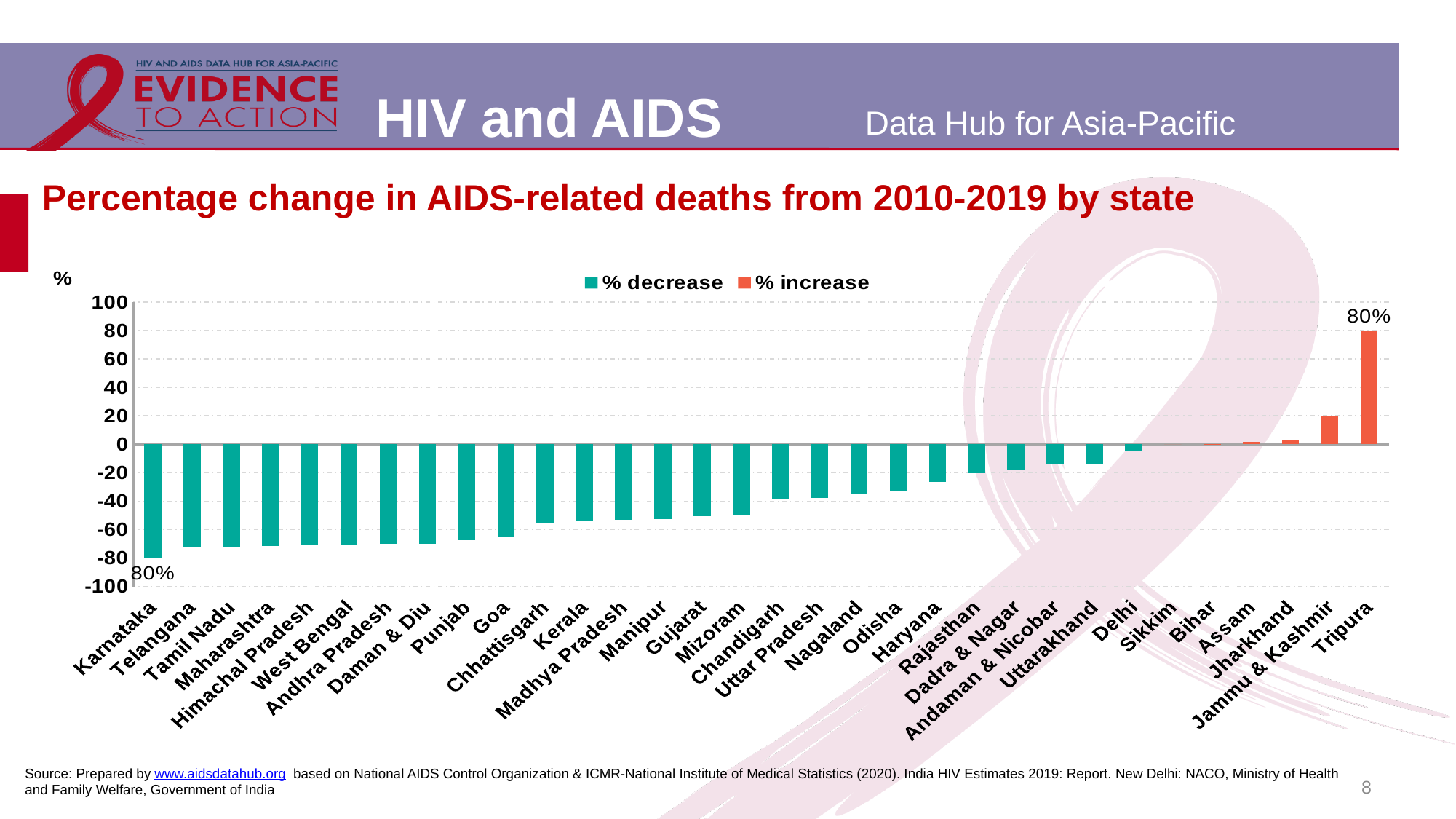
Do the values rise or fall moving from left to right along the x axis? Rise How many series does the legend list? 2 Is the value for Nagaland greater or less than -40? greater How many states/territories are shown on the x axis? 32 Which state has the highest percentage change (largest increase)? Tripura Is the value for Telangana greater or less than -60? less Which has the larger value, Tripura or Jammu & Kashmir? Tripura What is the data label shown for Tripura? 80% What are the two series named in the legend? % decrease and % increase Which state has the lowest percentage change (largest decrease)? Karnataka What type of chart is shown on the slide? Bar chart What is the data label shown for Karnataka? 80%